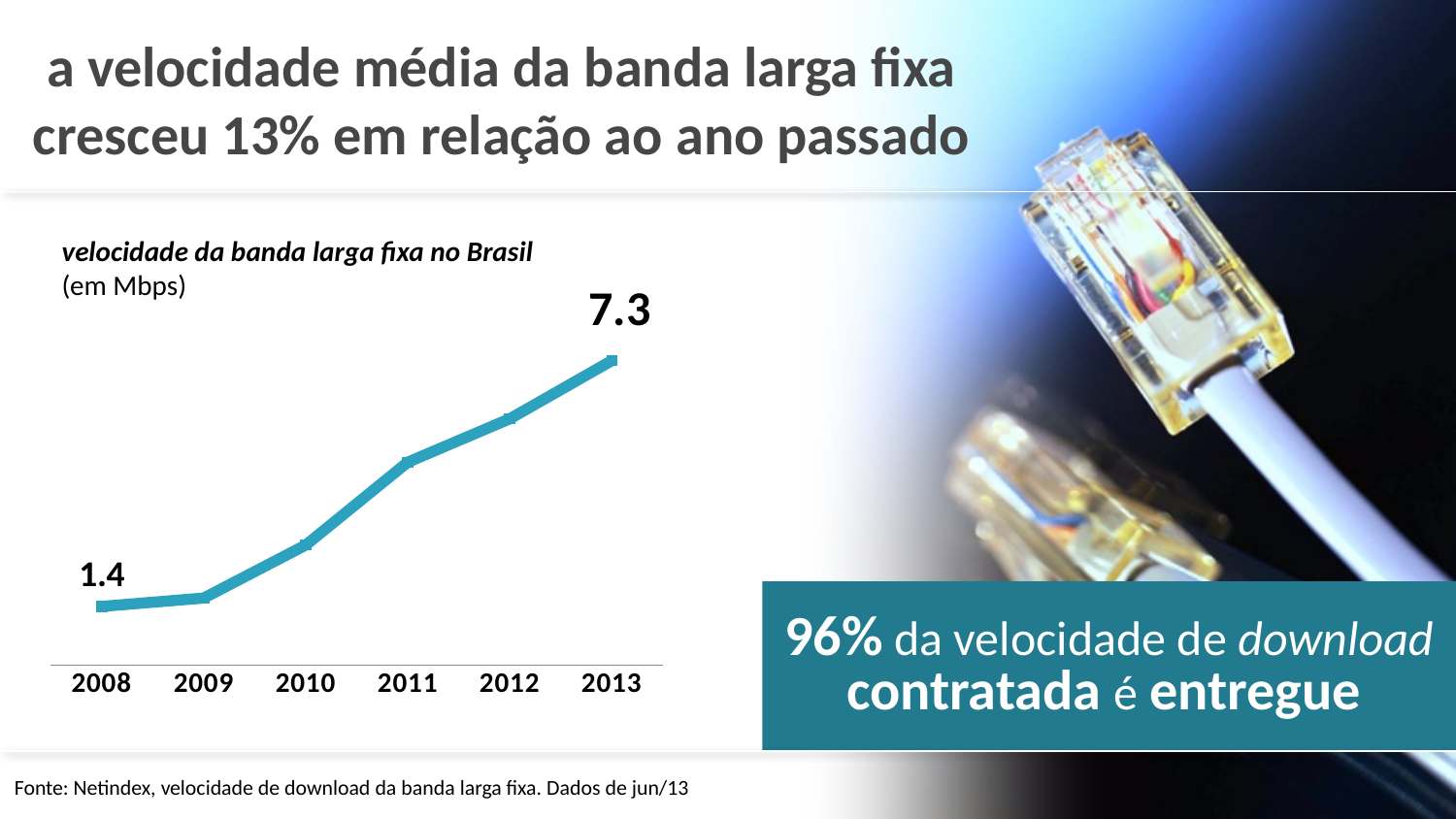
What kind of chart is shown on the slide? line chart Which year has the lowest value in the chart? 2008 Which is larger, the value for 2011 or the value for 2009? 2011 Do the values rise or fall from 2008 to 2013? rise What is the value for 2008 in the chart? 1.4 What is the difference between the 2013 value and the 2008 value? 5.9 In what unit are the chart values expressed? Mbps How many years are shown on the x axis of the chart? 6 Which year has the highest value in the chart? 2013 What is the value for 2013 in the chart? 7.3 Which is larger, the value for 2012 or the value for 2010? 2012 What is the title of the chart? velocidade da banda larga fixa no Brasil